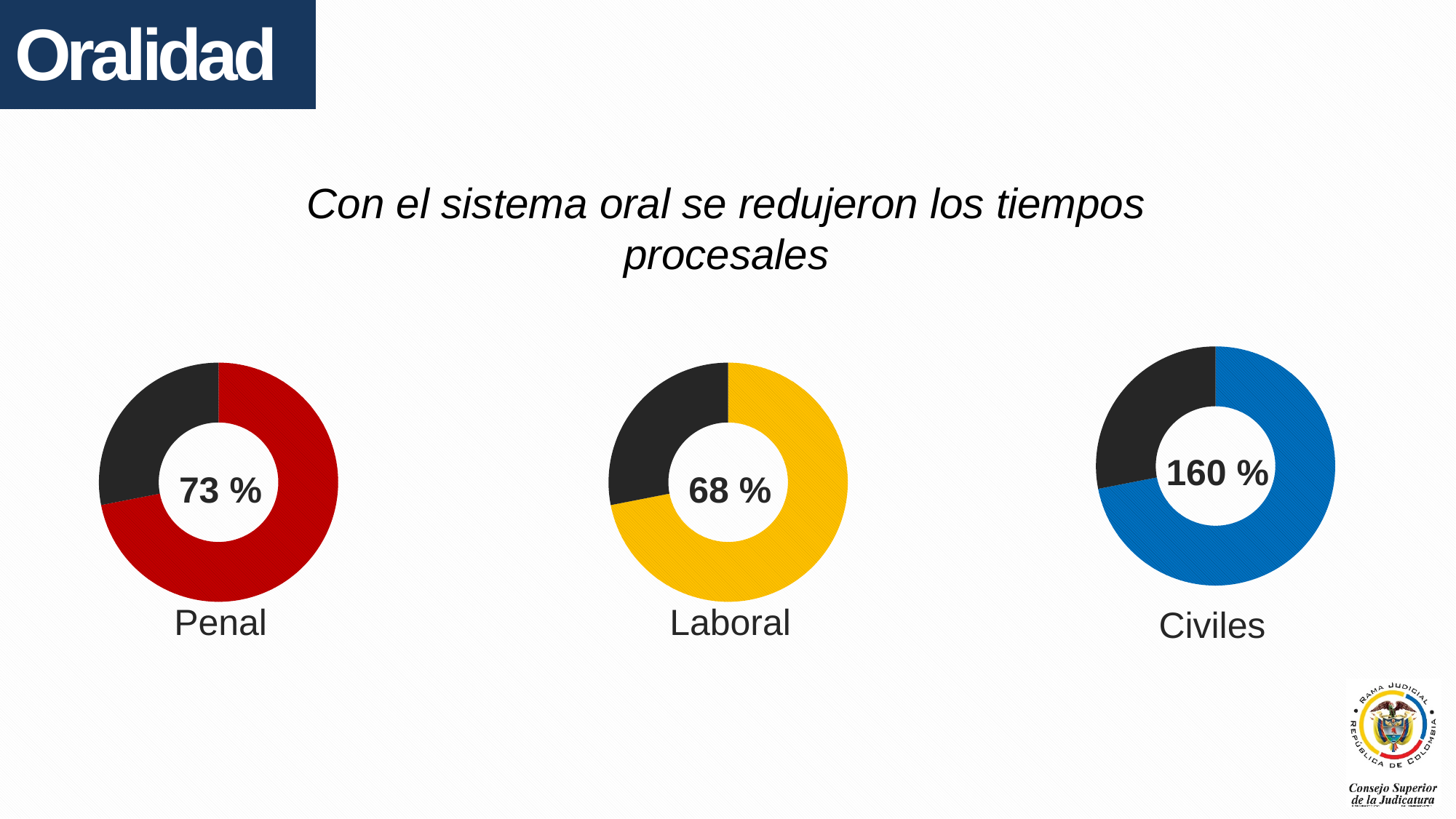
What colour is the main slice of the Civiles donut chart? Blue Which shows a larger percentage, the Penal chart or the Laboral chart? Penal What colour is the main slice of the Laboral donut chart? Yellow What value is shown in the centre of the Laboral donut chart? 68 % What kind of chart is used to show the Penal, Laboral and Civiles values? Donut (pie) chart What value is shown in the centre of the Civiles donut chart? 160 % Which of the three donut charts shows the lowest percentage? Laboral What is the difference between the percentage shown for Penal and the percentage shown for Laboral? 5 % What value is shown in the centre of the Penal donut chart? 73 % Which of the three donut charts shows the highest percentage? Civiles How many donut charts are on the slide? 3 What is the difference between the percentage shown for Civiles and the percentage shown for Penal? 87 %